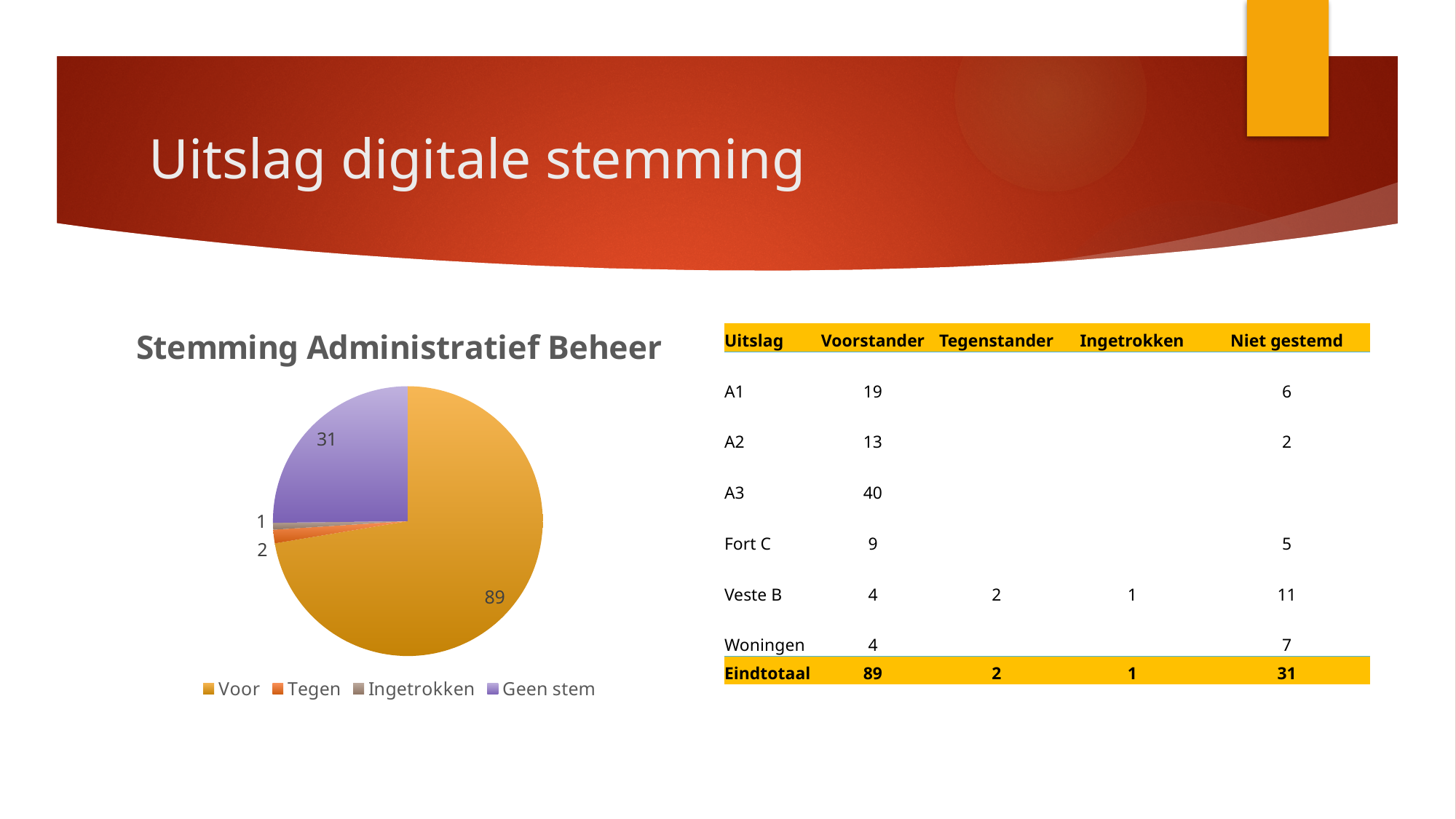
What type of chart is shown on the slide? pie chart Which slice of the pie chart is the largest? Voor What is the value of the Geen stem slice in the pie chart? 31 Which slice of the pie chart is the smallest? Ingetrokken What is the value of the Ingetrokken slice in the pie chart? 1 Which is larger in the pie chart, Tegen or Ingetrokken? Tegen What is the value of the Tegen slice in the pie chart? 2 What is the difference between the Voor and Geen stem values in the pie chart? 58 How many slices does the pie chart have? 4 How many entries does the legend of the pie chart list? 4 What is the title of the chart? Stemming Administratief Beheer What is the value of the Voor slice in the pie chart? 89